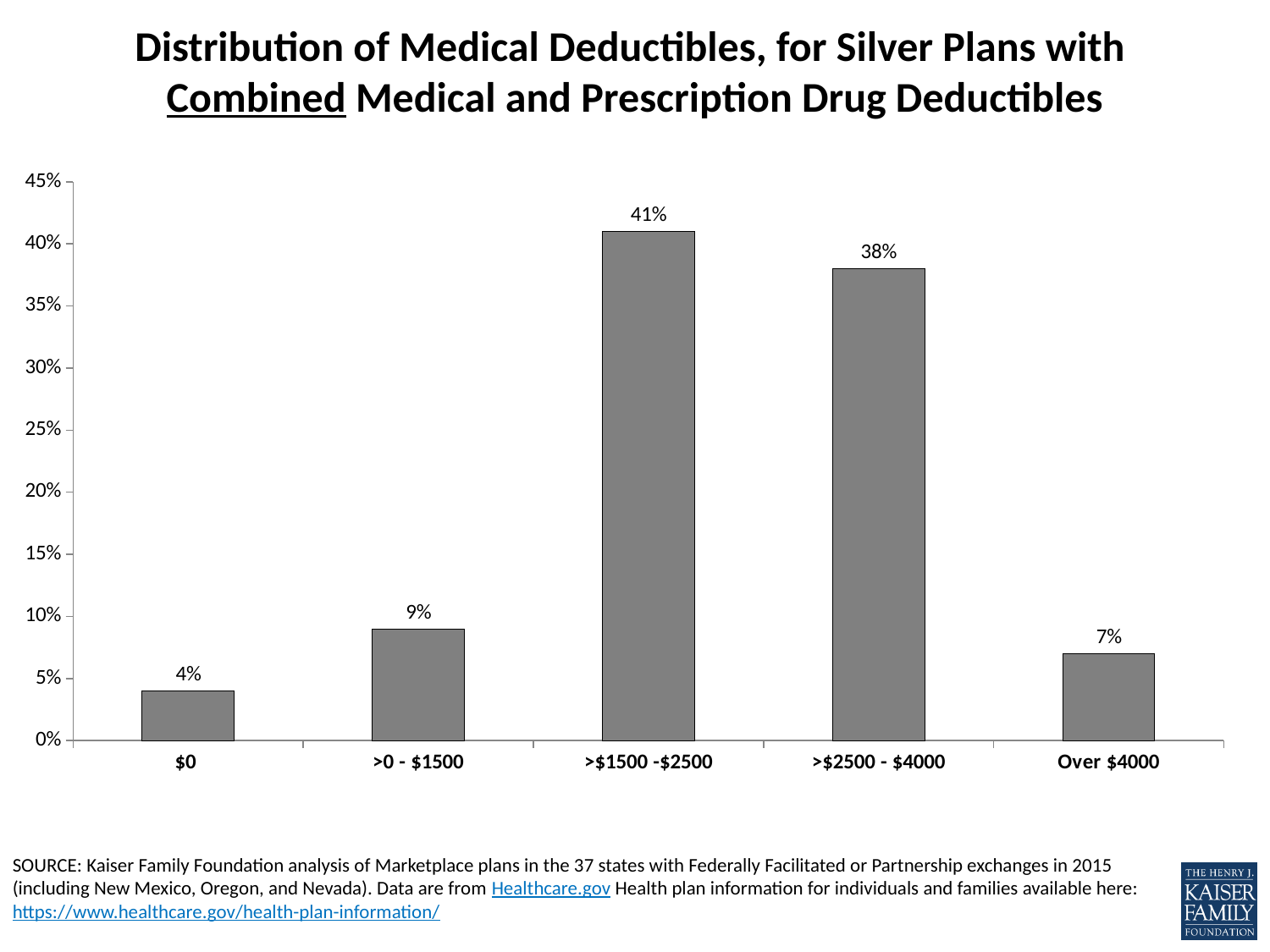
What is the highest value shown on the vertical axis? 45% What is the difference in percentage points between the ">$1500 -$2500" and ">$2500 - $4000" categories? 3 percentage points Which deductible range has the lowest share of plans? $0 What percentage of silver plans with combined deductibles have a medical deductible of $0? 4% What is the value shown for the ">$1500 -$2500" deductible range? 41% What percentage of plans fall in the "Over $4000" category? 7% Is the value for ">$2500 - $4000" greater or less than 35%? greater How many deductible categories are shown on the chart? 5 What kind of chart is shown on the slide? Bar chart Which deductible range has the highest share of plans? >$1500 -$2500 Which is larger: the share for ">0 - $1500" or the share for "Over $4000"? >0 - $1500 What is the combined share of plans in the ">$1500 -$2500" and ">$2500 - $4000" categories? 79%